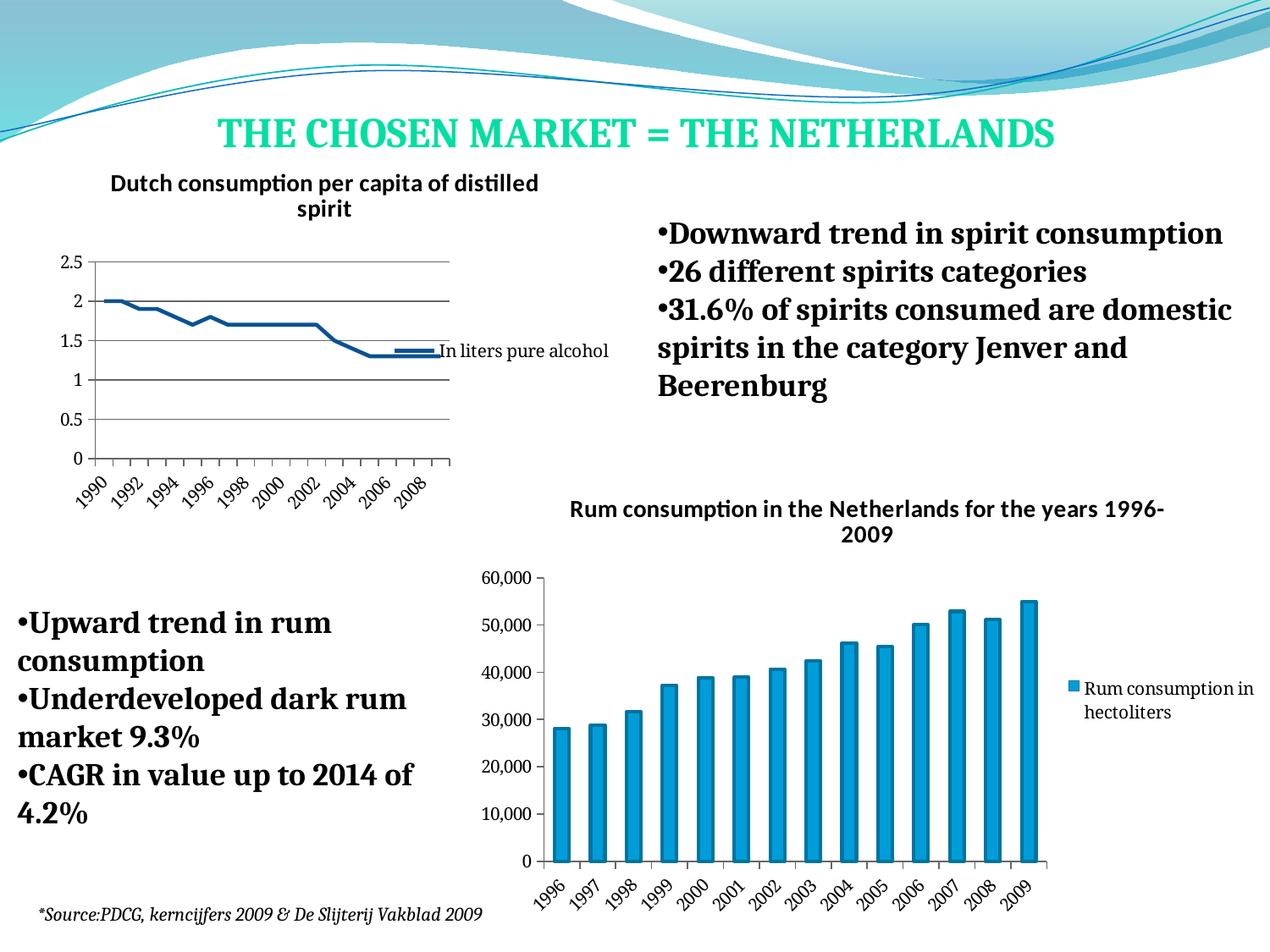
In the 'Dutch consumption per capita of distilled spirit' chart, do the values generally rise or fall from 1990 to 2008? Fall In the 'Rum consumption in the Netherlands for the years 1996-2009' chart, which year has the highest rum consumption? 2009 In the 'Rum consumption in the Netherlands for the years 1996-2009' chart, is the value for 1996 greater or less than 30,000? less In the 'Rum consumption in the Netherlands for the years 1996-2009' chart, do the values generally rise or fall from 1996 to 2009? Rise In the 'Rum consumption in the Netherlands for the years 1996-2009' chart, which year has the larger value, 2007 or 2008? 2007 What type of chart is the 'Rum consumption in the Netherlands for the years 1996-2009' chart? Bar chart In the 'Dutch consumption per capita of distilled spirit' chart, is the value for 2006 greater or less than 1.5? less What is the legend entry in the 'Dutch consumption per capita of distilled spirit' chart? In liters pure alcohol In the 'Rum consumption in the Netherlands for the years 1996-2009' chart, is the value for 2009 greater or less than 50,000? greater What type of chart is the 'Dutch consumption per capita of distilled spirit' chart? Line chart How many years are shown in the 'Rum consumption in the Netherlands for the years 1996-2009' chart? 14